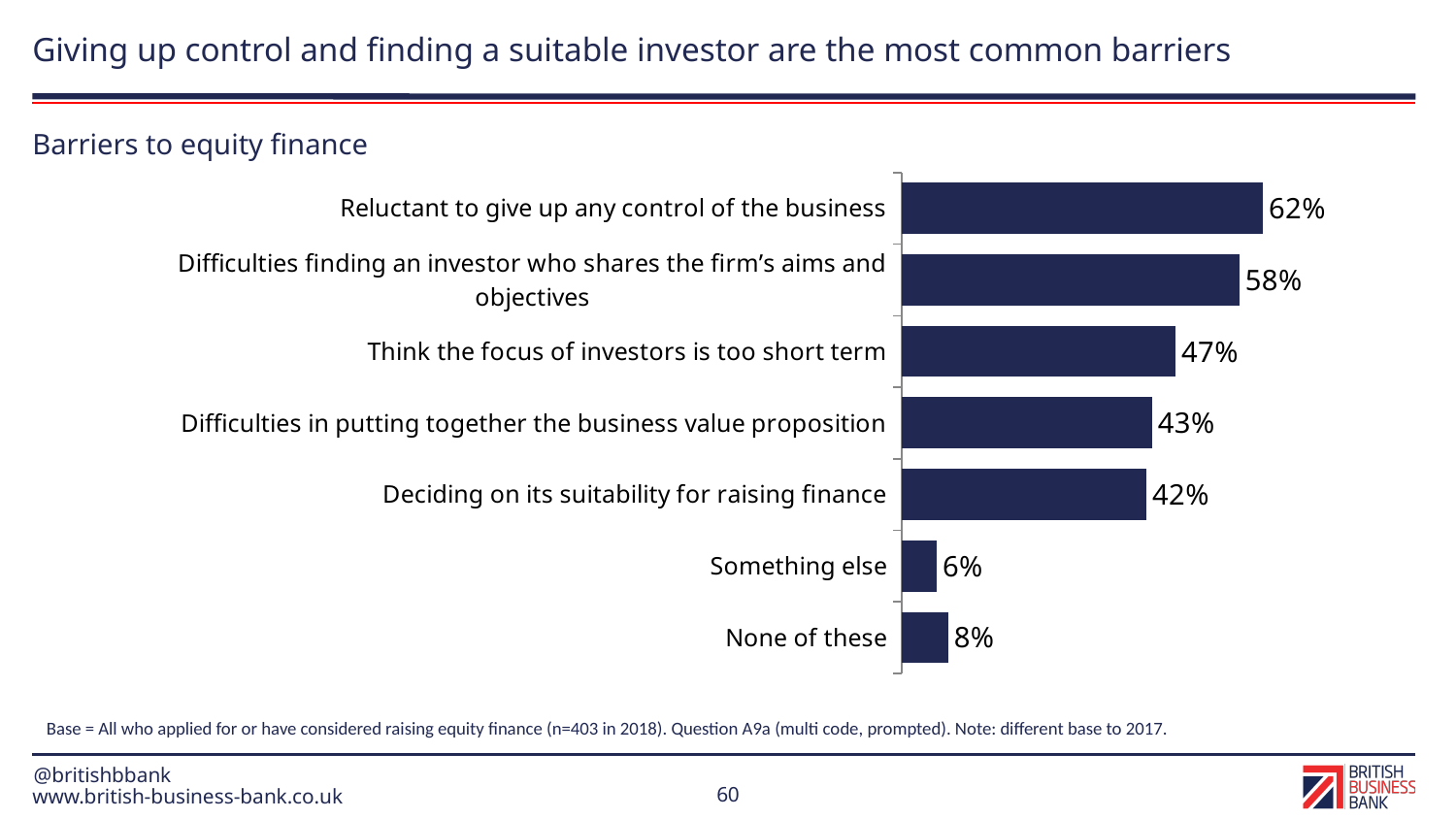
Which is larger: 'Something else' or 'None of these'? None of these What is the value for 'Think the focus of investors is too short term'? 47% What is the title of the chart? Barriers to equity finance What percentage is shown for 'None of these'? 8% Which barrier has the highest percentage? Reluctant to give up any control of the business Which is larger: 'Difficulties in putting together the business value proposition' or 'Deciding on its suitability for raising finance'? Difficulties in putting together the business value proposition What percentage of respondents cited 'Reluctant to give up any control of the business' as a barrier? 62% What is the difference between 'Reluctant to give up any control of the business' and 'Difficulties finding an investor who shares the firm's aims and objectives'? 4 percentage points What is the difference between 'Think the focus of investors is too short term' and 'Deciding on its suitability for raising finance'? 5 percentage points What type of chart is shown on the slide? Bar chart How many categories are shown in the chart? 7 Which category has the lowest percentage? Something else